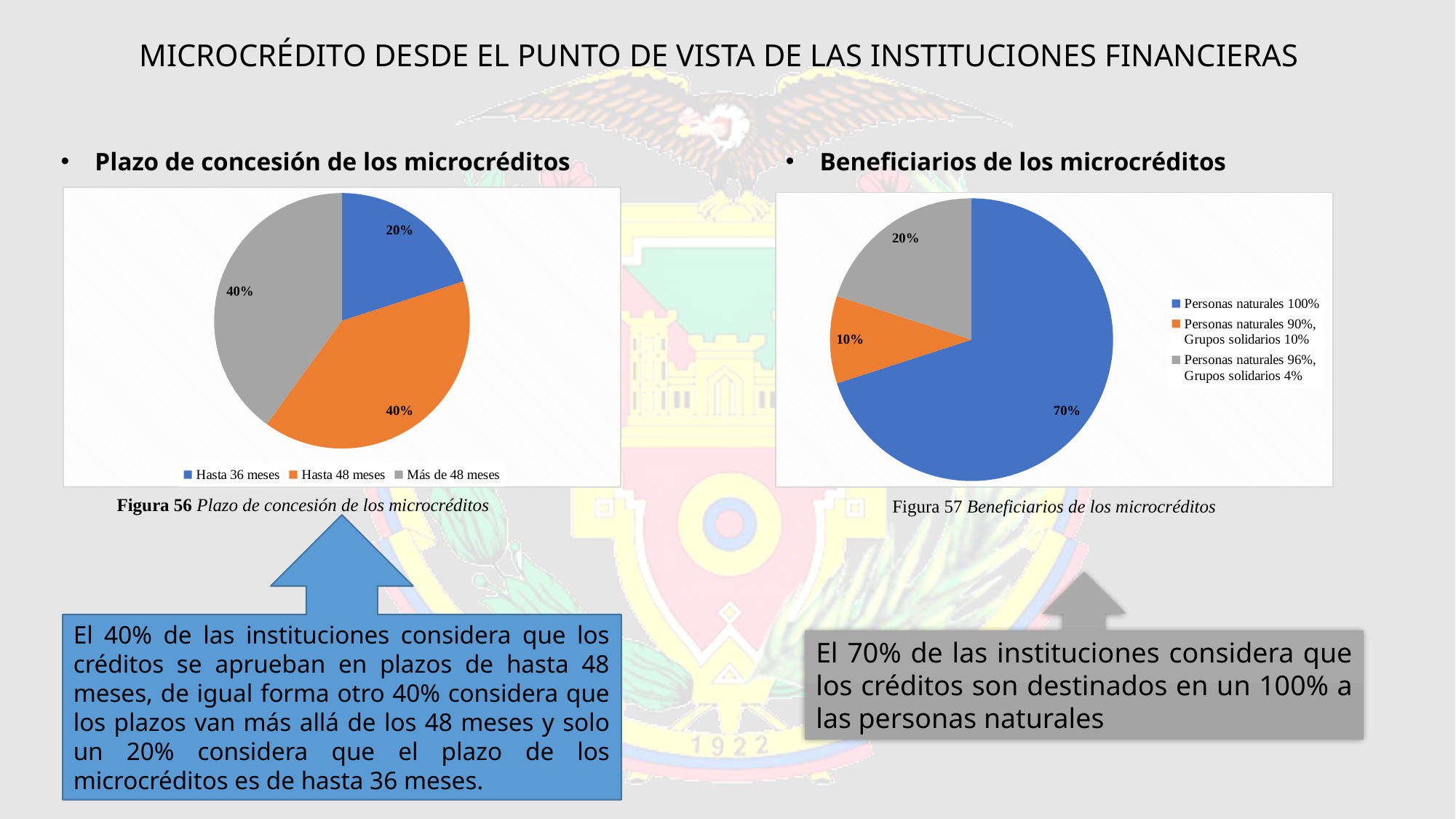
In the right chart (Beneficiarios de los microcréditos), what share does 'Personas naturales 90%, Grupos solidarios 10%' have? 10% In the right chart (Beneficiarios de los microcréditos), what share does 'Personas naturales 96%, Grupos solidarios 4%' have? 20% In the left chart (Plazo de concesión de los microcréditos), what share does 'Hasta 36 meses' have? 20% In the right chart (Beneficiarios de los microcréditos), which category has the largest slice? Personas naturales 100% In the left chart (Plazo de concesión de los microcréditos), what colour is the 'Más de 48 meses' slice? Grey What kind of chart is the left chart (Plazo de concesión de los microcréditos)? Pie chart In the left chart (Plazo de concesión de los microcréditos), which category has the smallest slice? Hasta 36 meses In the left chart (Plazo de concesión de los microcréditos), how many categories does the legend list? 3 In the right chart (Beneficiarios de los microcréditos), which is larger: 'Personas naturales 96%, Grupos solidarios 4%' or 'Personas naturales 90%, Grupos solidarios 10%'? Personas naturales 96%, Grupos solidarios 4% In the right chart (Beneficiarios de los microcréditos), what is the difference between the largest and smallest slices? 60%